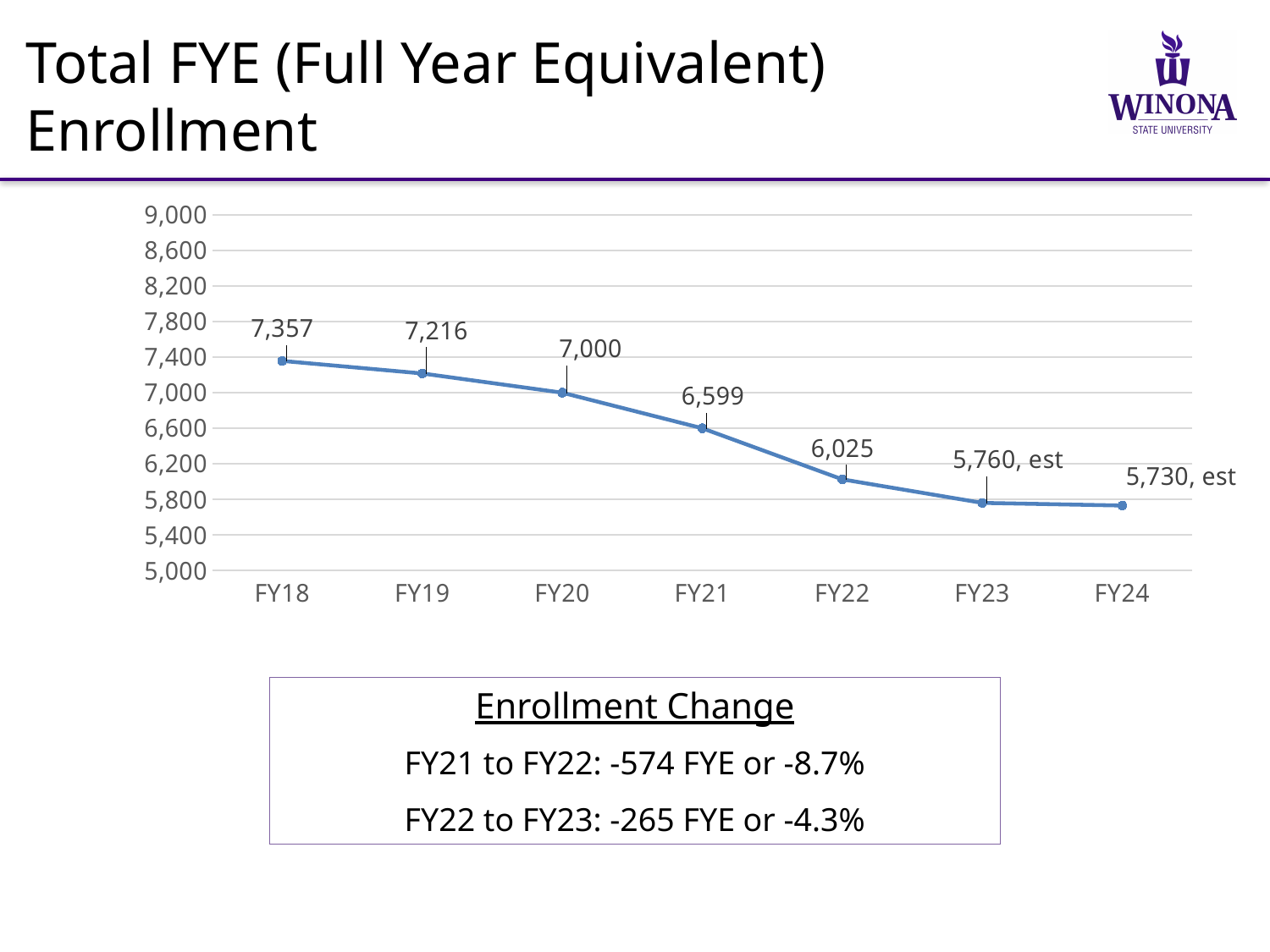
What is the data label shown for FY23? 5,760, est What is the FYE enrollment value for FY21? 6,599 What is the FYE enrollment value for FY18? 7,357 Do the FYE enrollment values rise or fall from FY18 to FY24? fall Which is larger, the FYE enrollment for FY20 or for FY22? FY20 What is the difference in FYE enrollment between FY21 and FY22? 574 What is the difference in FYE enrollment between FY19 and FY20? 216 Which fiscal year has the highest FYE enrollment? FY18 What kind of chart is shown on the slide? line chart Is the value for FY22 greater or less than 6,200? less How many fiscal years are plotted on the chart? 7 Which fiscal year has the lowest FYE enrollment? FY24